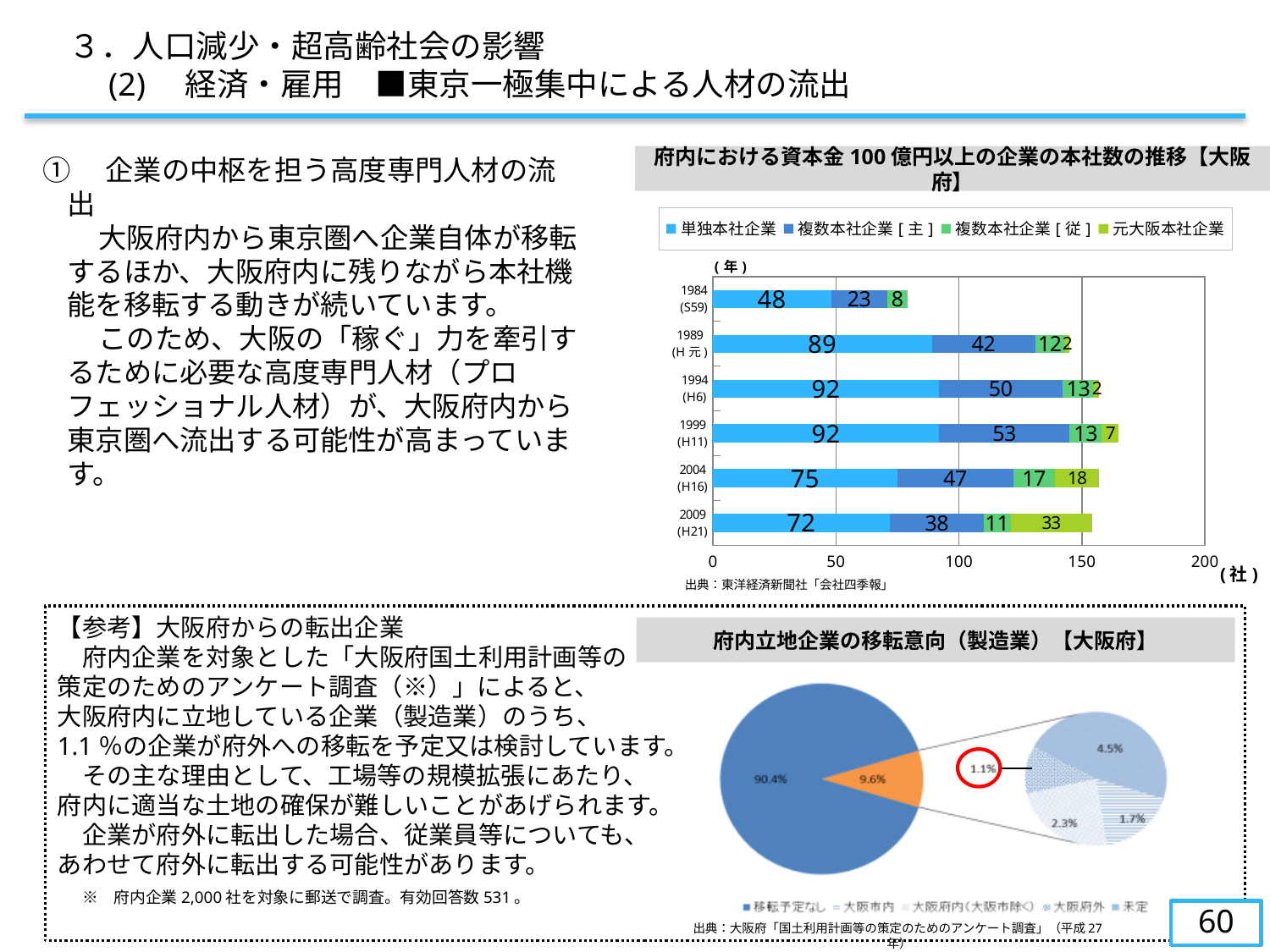
In the chart titled 府内における資本金100億円以上の企業の本社数の推移【大阪府】, which is larger: 複数本社企業[主] in 1989 (H元) or 複数本社企業[主] in 2009 (H21)? 1989 (H元) In the chart titled 府内における資本金100億円以上の企業の本社数の推移【大阪府】, what is the difference between the 単独本社企業 values for 1994 (H6) and 2009 (H21)? 20 In the chart titled 府内における資本金100億円以上の企業の本社数の推移【大阪府】, which year has the lowest value for 単独本社企業? 1984 (S59) In the chart titled 府内における資本金100億円以上の企業の本社数の推移【大阪府】, what is the total of the stacked bar for 2009 (H21)? 154 In the chart titled 府内立地企業の移転意向（製造業）【大阪府】, what is the share of the largest slice of the main pie? 90.4% In the chart titled 府内における資本金100億円以上の企業の本社数の推移【大阪府】, what is the value for 単独本社企業 in 1984 (S59)? 48 What kind of chart is the one titled 府内における資本金100億円以上の企業の本社数の推移【大阪府】? Stacked bar chart In the chart titled 府内における資本金100億円以上の企業の本社数の推移【大阪府】, what is the value for 複数本社企業[主] in 1999 (H11)? 53 In the chart titled 府内における資本金100億円以上の企業の本社数の推移【大阪府】, how many series does the legend list? 4 In the chart titled 府内における資本金100億円以上の企業の本社数の推移【大阪府】, how many years are shown on the vertical axis? 6 In the chart titled 府内における資本金100億円以上の企業の本社数の推移【大阪府】, what is the value for 元大阪本社企業 in 2009 (H21)? 33 What kind of chart is the one titled 府内立地企業の移転意向（製造業）【大阪府】? Pie chart